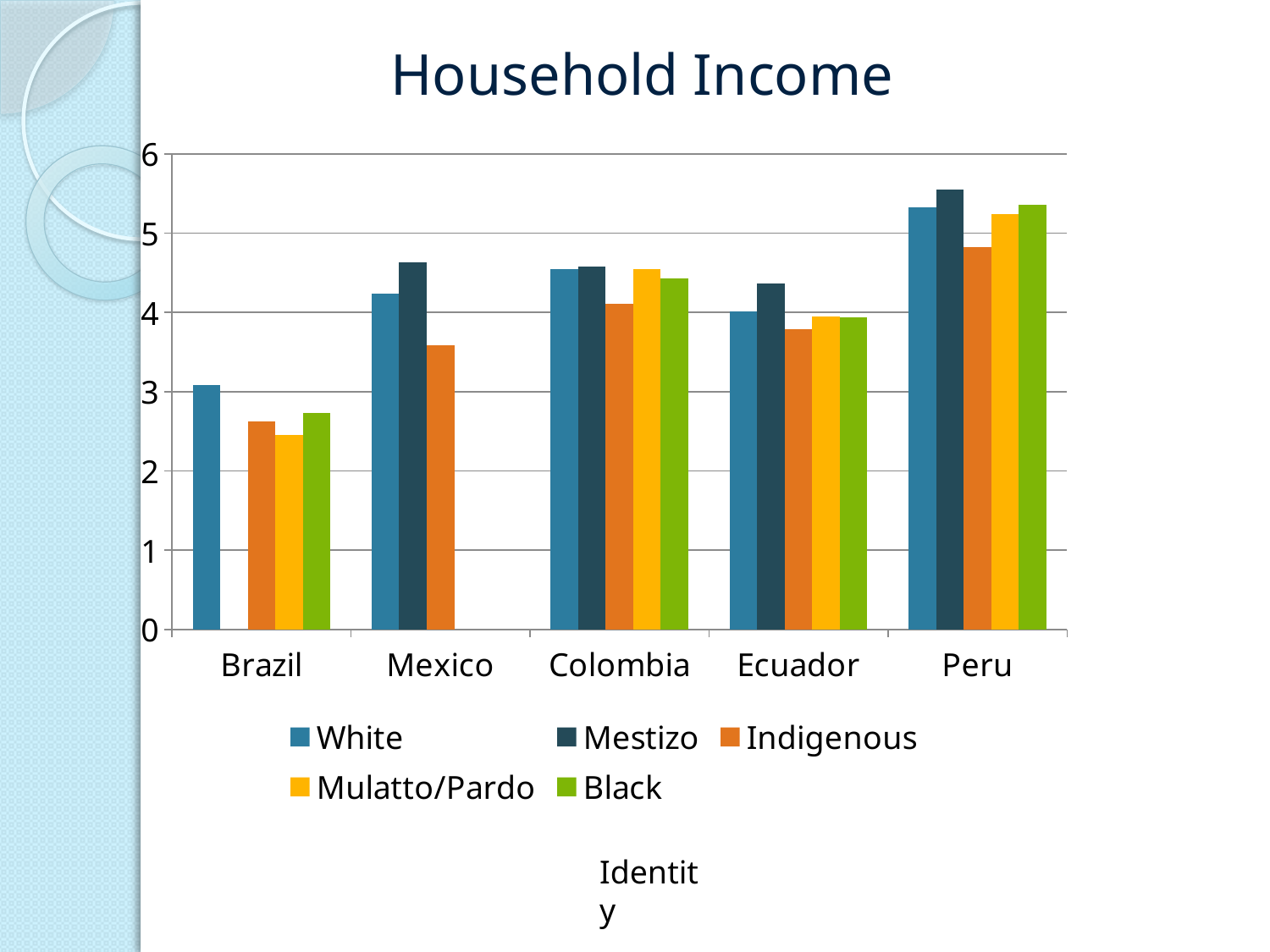
Is the Mulatto/Pardo value for Brazil greater or less than 3? less Which country has the highest value for the White series? Peru What kind of chart is shown on the slide? bar chart In Mexico, which is larger, the Mestizo value or the Indigenous value? Mestizo How many countries are shown on the x axis? 5 Is the Mestizo value for Peru greater or less than 5? greater In Peru, which series has the lowest value? Indigenous Which country has the lowest value for the White series? Brazil What is the title of the chart? Household Income Which country has the highest value for the Indigenous series? Peru Is the Indigenous value for Mexico greater or less than 4? less How many series does the legend list? 5